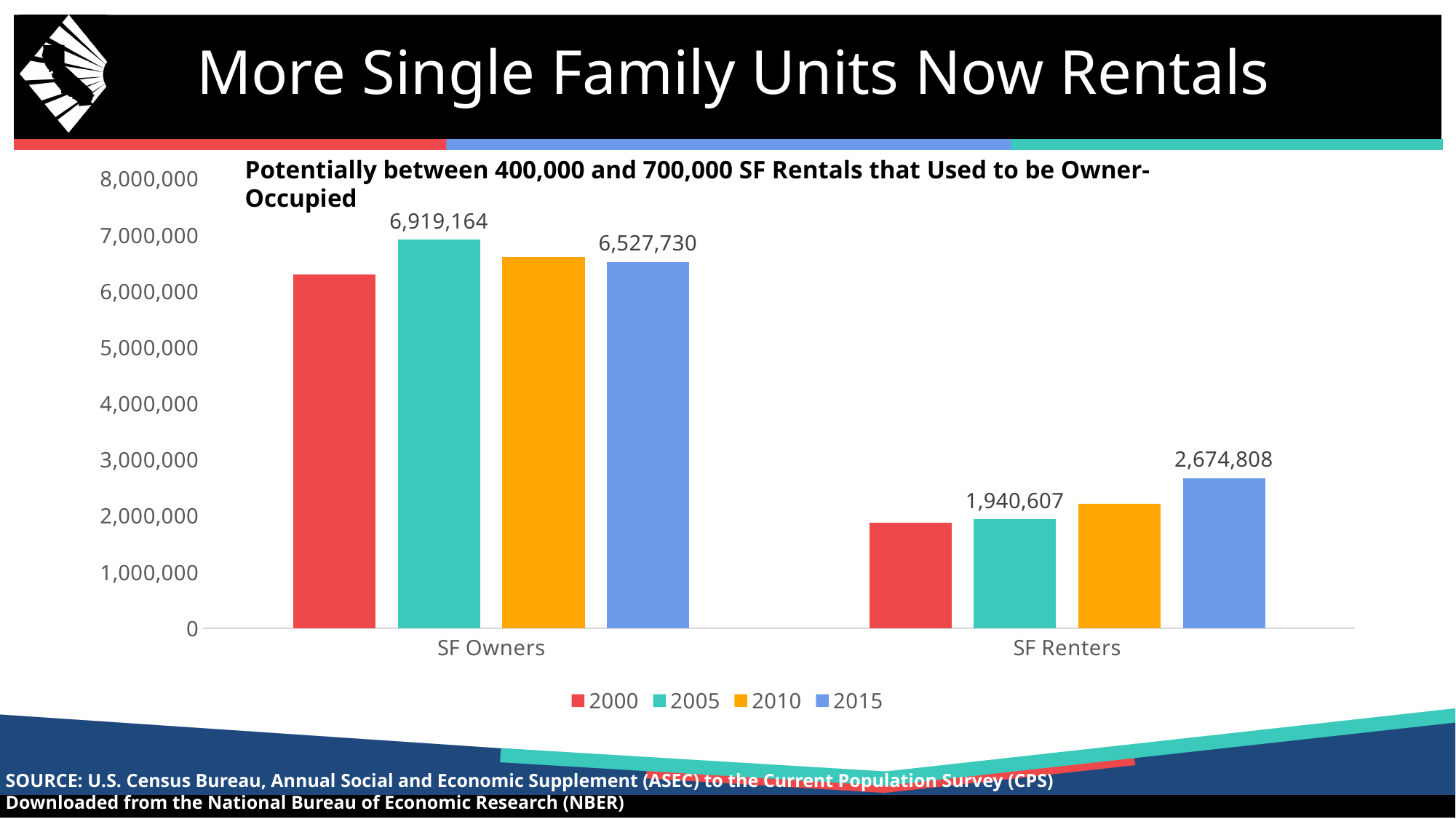
Is the value for SF Renters in 2010 greater or less than 2,000,000? greater What is the value for SF Owners in 2005? 6,919,164 By how much did the SF Owners value fall from 2005 to 2015? 391,434 By how much did the SF Renters value rise from 2005 to 2015? 734,201 What kind of chart is shown on the slide? Bar chart Which year has the highest value for SF Renters? 2015 How many series does the legend list? 4 What is the value for SF Renters in 2005? 1,940,607 What is the value for SF Renters in 2015? 2,674,808 Is the value for SF Owners in 2010 greater or less than 6,000,000? greater What is the value for SF Owners in 2015? 6,527,730 Which year has the highest value for SF Owners? 2005